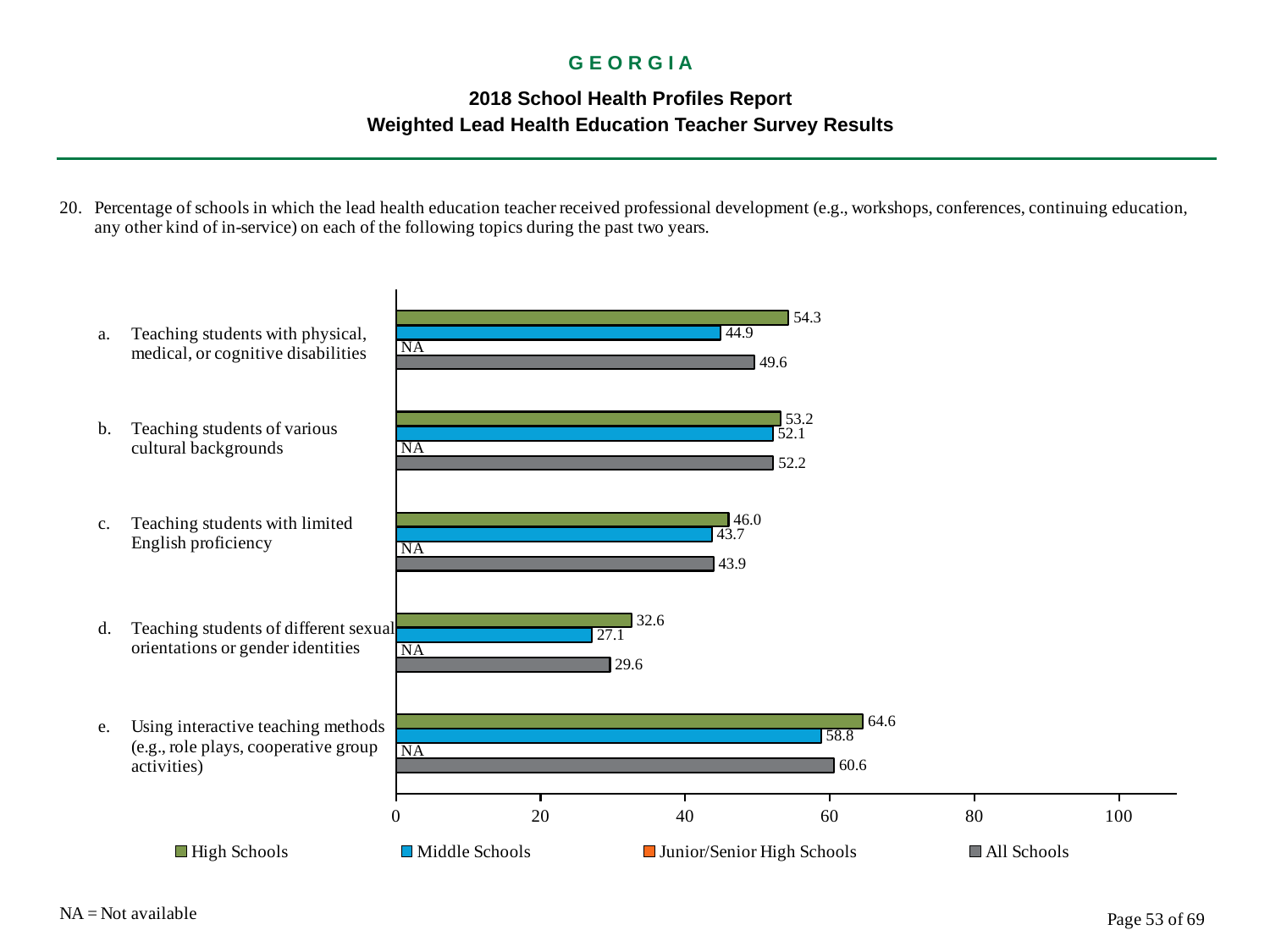
What is the difference between the High Schools and Middle Schools values for topic a, teaching students with physical, medical, or cognitive disabilities? 9.4 What kind of chart is shown on the slide? Bar chart Which topic has the lowest High Schools value? d. Teaching students of different sexual orientations or gender identities For topic c, teaching students with limited English proficiency, which is larger: the High Schools value or the All Schools value? High Schools How many topics are listed on the chart? 5 How many series does the legend list? 4 What is the Middle Schools value for topic d, teaching students of different sexual orientations or gender identities? 27.1 Which topic has the highest All Schools value? e. Using interactive teaching methods What is the All Schools value for topic a, teaching students with physical, medical, or cognitive disabilities? 49.6 What value is shown for Junior/Senior High Schools for each topic? NA What is the Middle Schools value for topic b, teaching students of various cultural backgrounds? 52.1 What is the High Schools value for topic e, using interactive teaching methods? 64.6